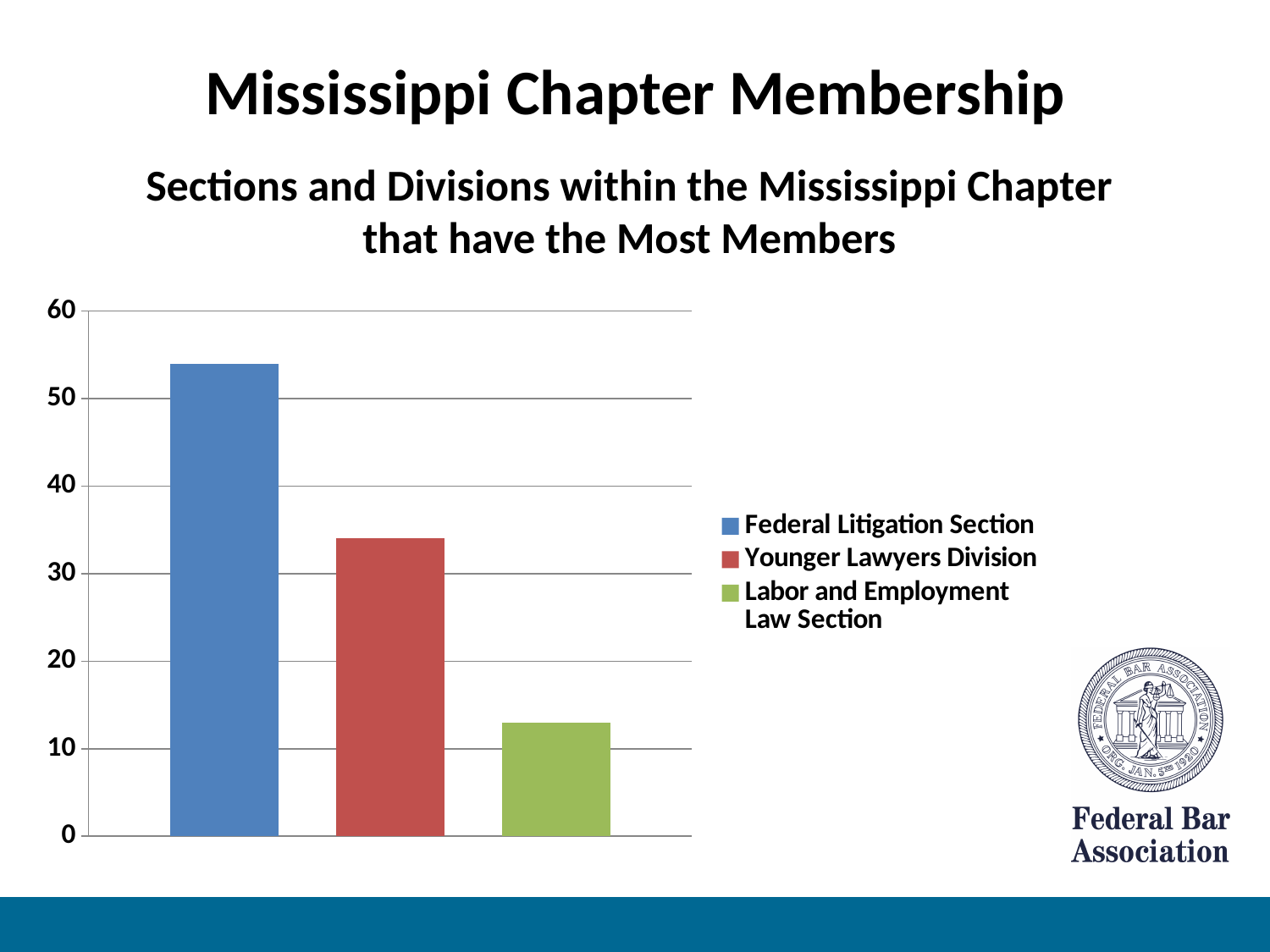
What kind of chart is shown on the slide? bar chart Is the value for the Younger Lawyers Division greater or less than 30? greater Which section or division has the highest membership in the chart? Federal Litigation Section Is the value for the Federal Litigation Section greater or less than 50? greater Which section or division has the lowest membership in the chart? Labor and Employment Law Section Which has more members, the Federal Litigation Section or the Younger Lawyers Division? Federal Litigation Section How many entries does the legend list? 3 What colour is the bar for the Younger Lawyers Division? red Is the value for the Labor and Employment Law Section greater or less than 20? less How many bars are plotted in the chart? 3 Which has more members, the Younger Lawyers Division or the Labor and Employment Law Section? Younger Lawyers Division